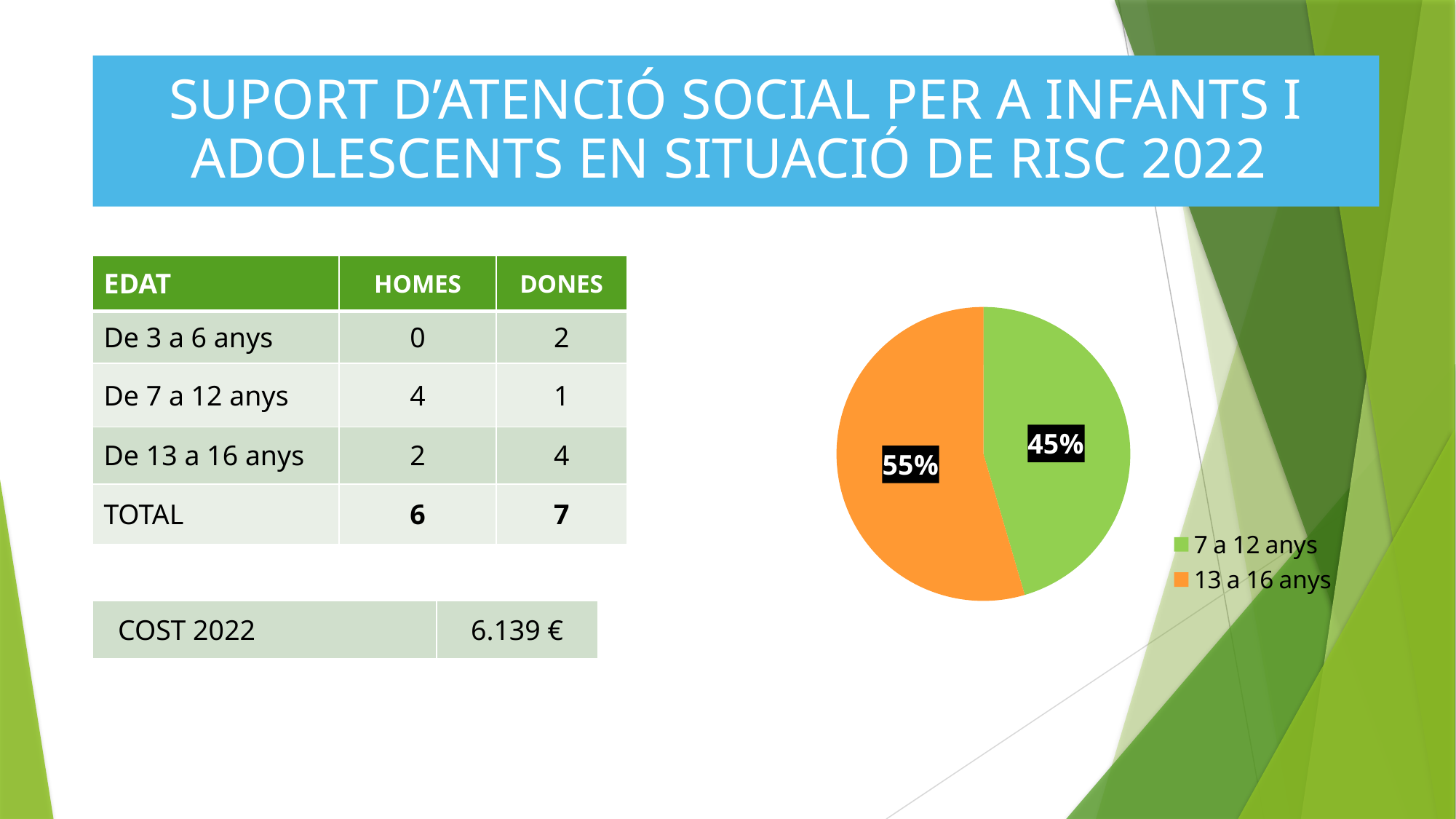
Which slice of the pie chart is the largest? 13 a 16 anys What is the difference in percentage points between the "13 a 16 anys" slice and the "7 a 12 anys" slice in the pie chart? 10% How many slices does the pie chart have? 2 What share of the pie chart does the "7 a 12 anys" slice represent? 45% What colour is the "7 a 12 anys" slice in the pie chart? green What colour is the "13 a 16 anys" slice in the pie chart? orange What share of the pie chart does the "13 a 16 anys" slice represent? 55% In the pie chart, which is larger: the "7 a 12 anys" slice or the "13 a 16 anys" slice? 13 a 16 anys Which slice of the pie chart is the smallest? 7 a 12 anys How many entries does the pie chart's legend list? 2 What kind of chart is shown on the slide? pie chart